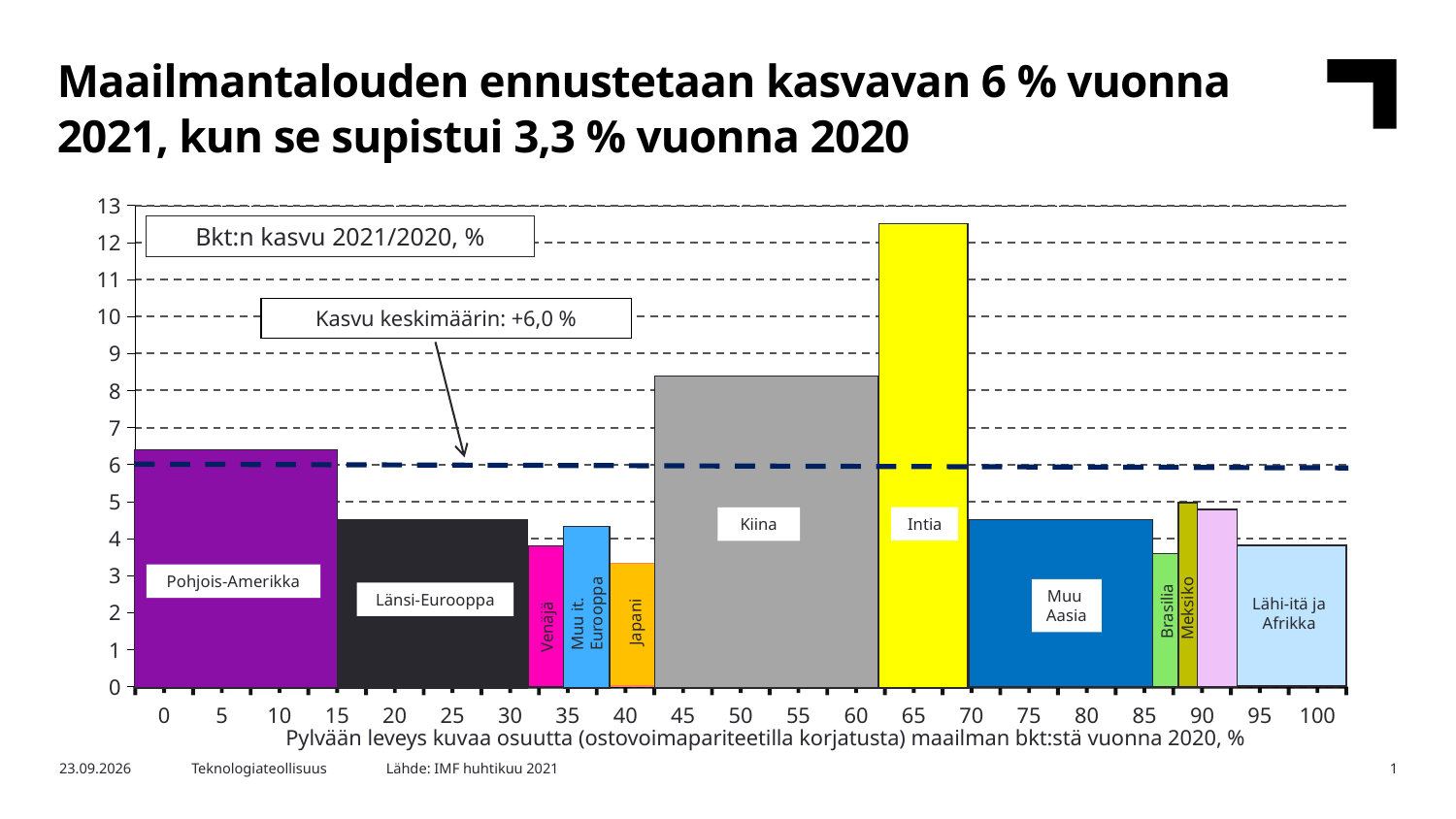
Is the value for Intia greater or less than 12? greater Which has the higher growth value, Meksiko or Brasilia? Meksiko Is the value for Lähi-itä ja Afrikka greater or less than 4? less What kind of chart is shown on the slide? bar chart What is the title shown inside the chart area? Bkt:n kasvu 2021/2020, % Is the value for Pohjois-Amerikka greater or less than 6? greater Which has the higher growth value, Kiina or Intia? Intia Which region has the highest GDP growth in the chart? Intia What is the average growth shown by the dashed line in the chart? +6,0 %